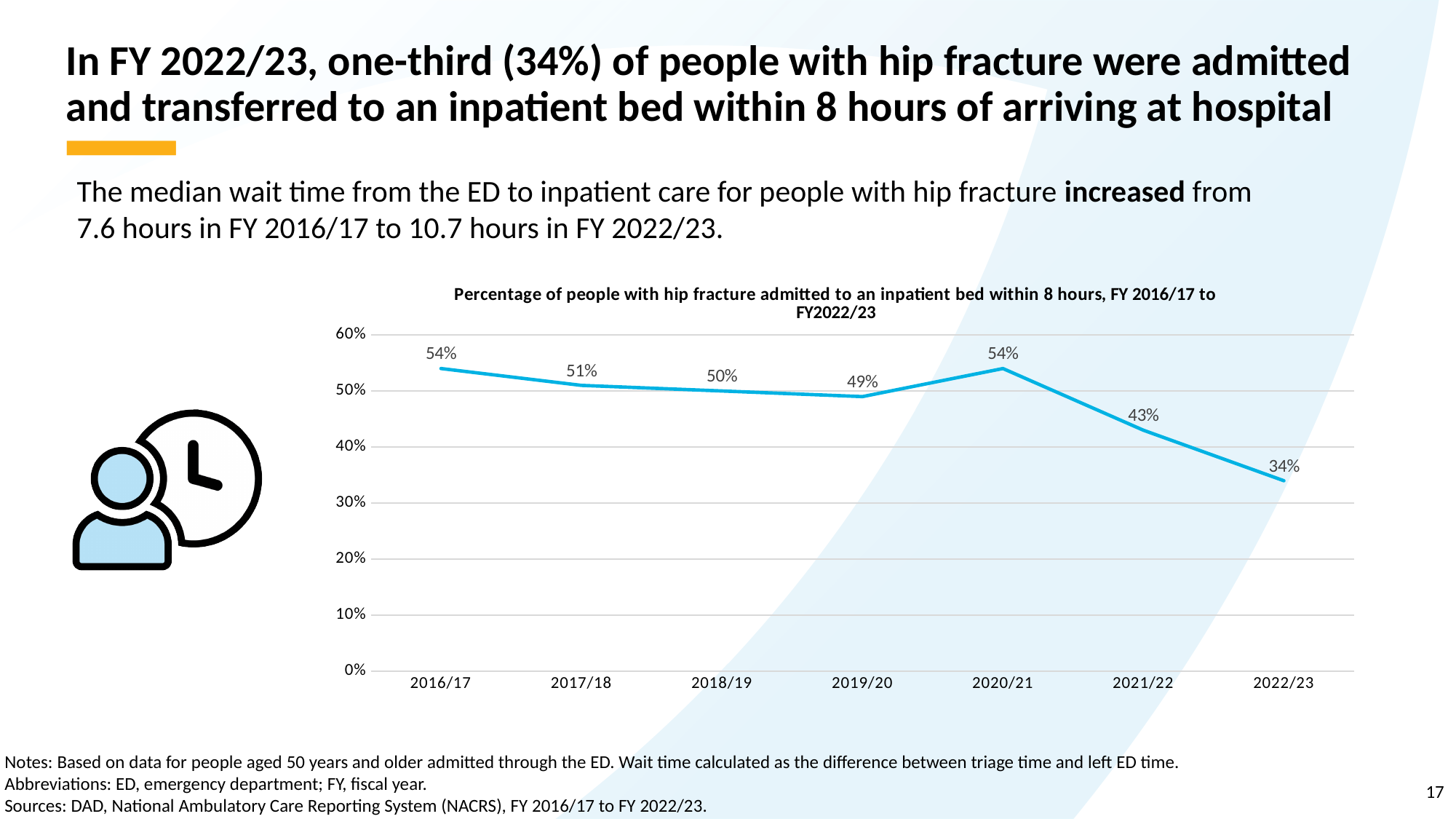
Does the percentage rise or fall from 2020/21 to 2022/23? Fall What is the value shown for 2019/20? 49% How many fiscal years are plotted on the chart? 7 Which fiscal year has the lowest percentage on the chart? 2022/23 What is the highest value shown on the vertical axis of the chart? 60% What kind of chart is shown on the slide? Line chart What percentage of people with hip fracture were admitted to an inpatient bed within 8 hours in FY 2022/23? 34% Is the value for 2021/22 greater or less than 50%? less What is the difference between the values for 2016/17 and 2017/18? 3 percentage points What is the value shown for 2021/22? 43% Which year has a higher value, 2018/19 or 2021/22? 2018/19 What is the difference in percentage points between 2020/21 and 2022/23? 20 percentage points